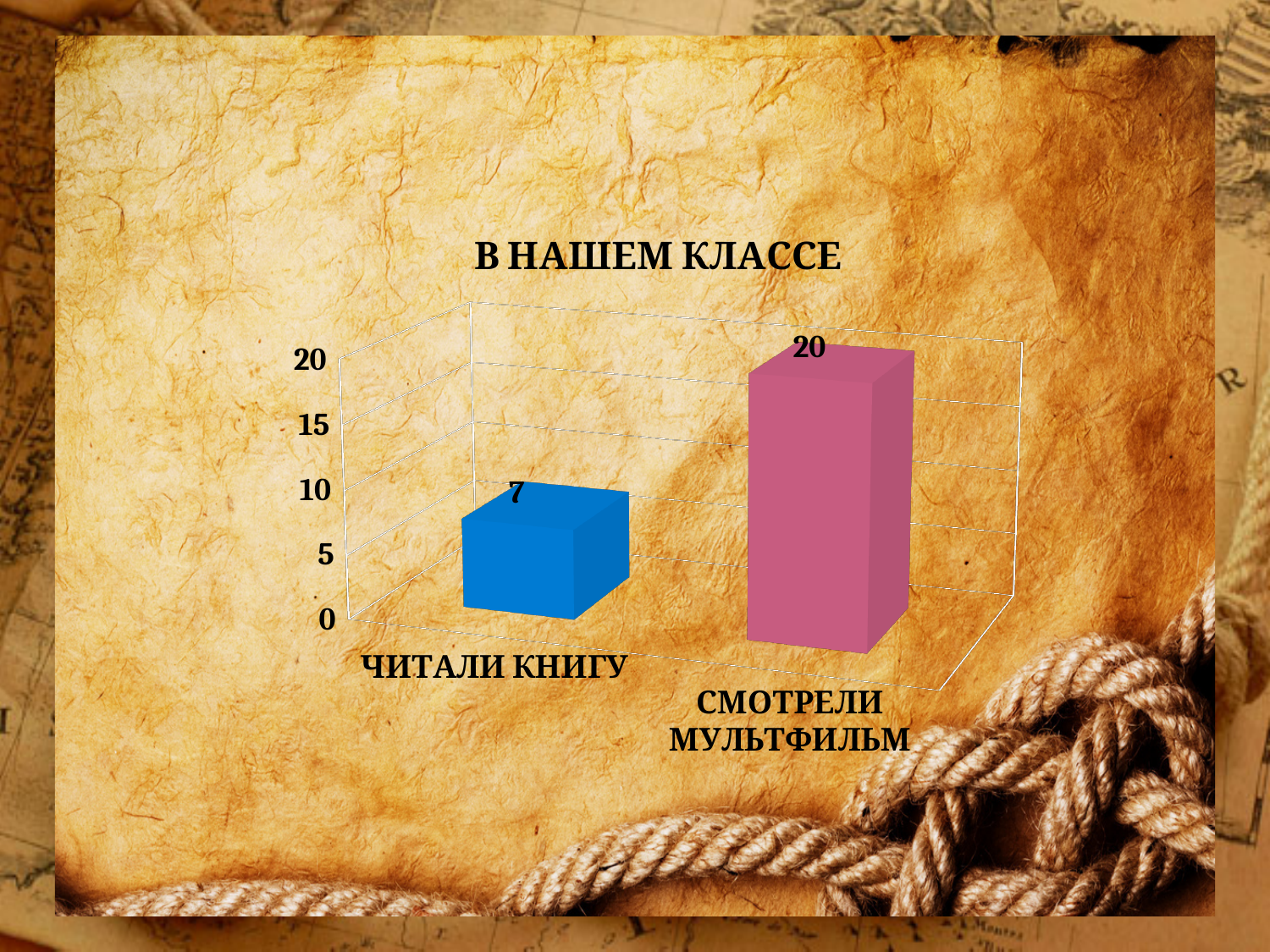
What is the value for ЧИТАЛИ КНИГУ? 7 What colour is the bar for СМОТРЕЛИ МУЛЬТФИЛЬМ? pink What kind of chart is shown on the slide? bar chart Which category has the lowest value? ЧИТАЛИ КНИГУ Which is larger: the value for ЧИТАЛИ КНИГУ or the value for СМОТРЕЛИ МУЛЬТФИЛЬМ? СМОТРЕЛИ МУЛЬТФИЛЬМ Is the value for СМОТРЕЛИ МУЛЬТФИЛЬМ greater or less than 15? greater Which category has the highest value? СМОТРЕЛИ МУЛЬТФИЛЬМ Is the value for ЧИТАЛИ КНИГУ greater or less than 10? less What is the value for СМОТРЕЛИ МУЛЬТФИЛЬМ? 20 What is the difference between the values for СМОТРЕЛИ МУЛЬТФИЛЬМ and ЧИТАЛИ КНИГУ? 13 How many categories are shown in the chart? 2 What is the title of the chart? В НАШЕМ КЛАССЕ